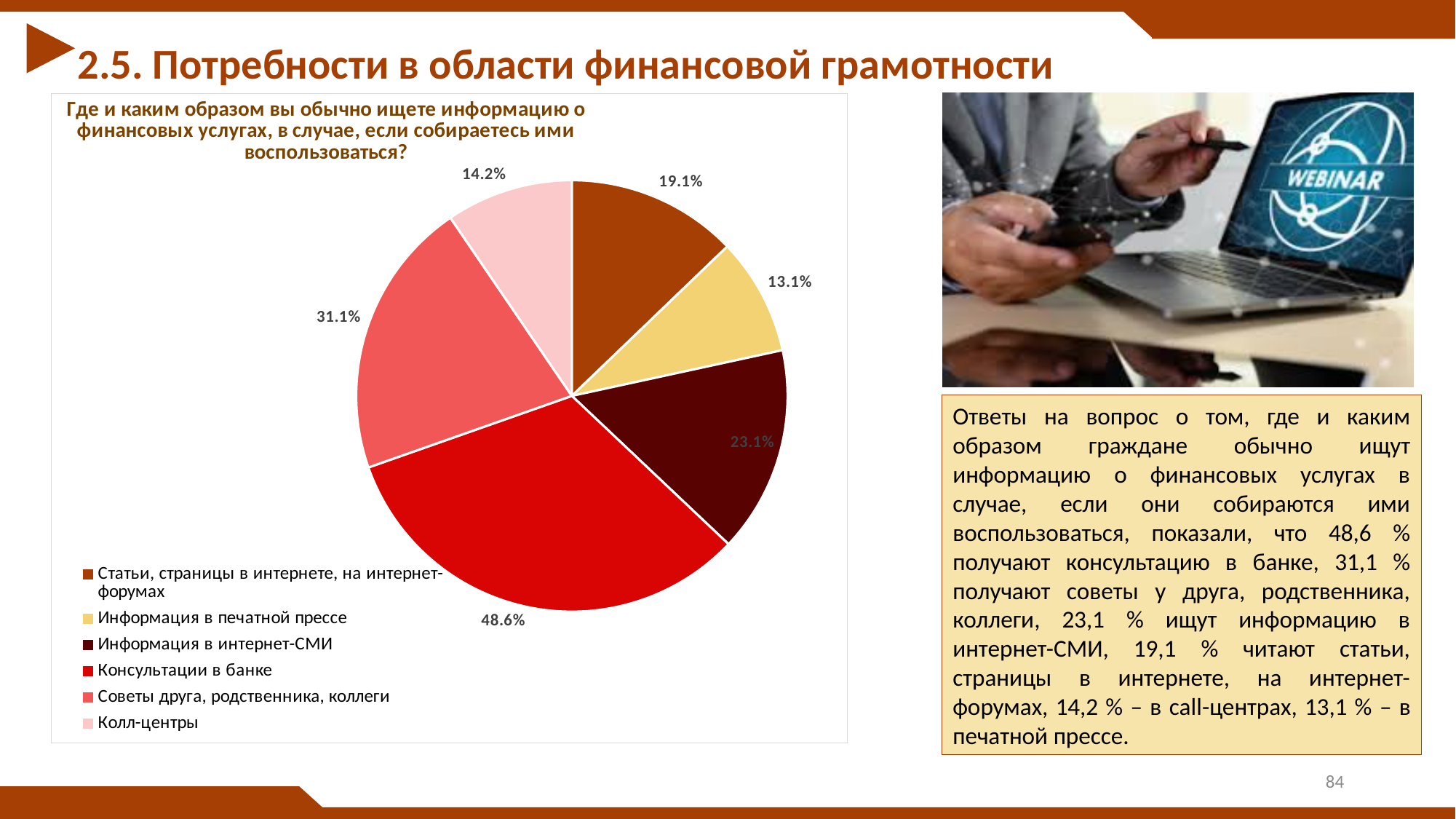
Which category has the smallest slice in the pie chart? Информация в печатной прессе Which is larger: "Информация в интернет-СМИ" or "Статьи, страницы в интернете, на интернет-форумах"? Информация в интернет-СМИ What kind of chart is shown on the slide? Pie chart What percentage is shown for "Информация в интернет-СМИ"? 23.1% What percentage is shown for "Советы друга, родственника, коллеги"? 31.1% What percentage is shown for "Консультации в банке"? 48.6% What is the difference between the values for "Консультации в банке" and "Советы друга, родственника, коллеги"? 17.5% What percentage is shown for "Информация в печатной прессе"? 13.1% How many categories does the pie chart show? 6 What is the title of the pie chart? Где и каким образом вы обычно ищете информацию о финансовых услугах, в случае, если собираетесь ими воспользоваться? Which category has the largest slice in the pie chart? Консультации в банке What percentage is shown for "Колл-центры"? 14.2%